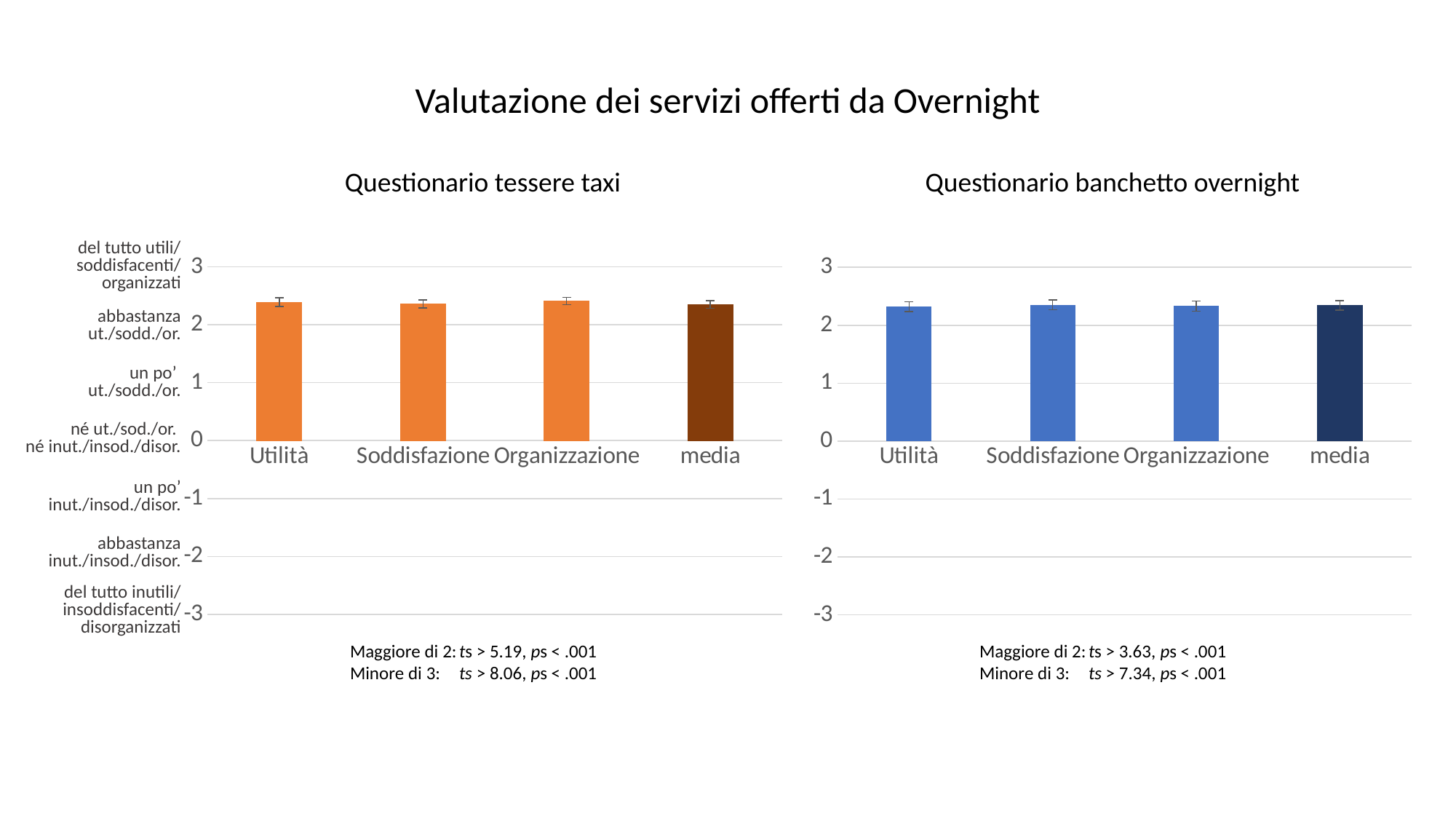
In the "Questionario banchetto overnight" chart, is the value for media greater or less than 0? greater What kind of chart is the "Questionario tessere taxi" chart? bar chart What is the title of the chart on the left side of the slide? Questionario tessere taxi What is the title of the chart on the right side of the slide? Questionario banchetto overnight How many bars are plotted in the "Questionario banchetto overnight" chart? 4 In the "Questionario tessere taxi" chart, is the value for Soddisfazione greater or less than 1? greater In the "Questionario banchetto overnight" chart, is the value for Organizzazione greater or less than 3? less How many categories are shown on the x axis of the "Questionario tessere taxi" chart? 4 What kind of chart is the "Questionario banchetto overnight" chart? bar chart